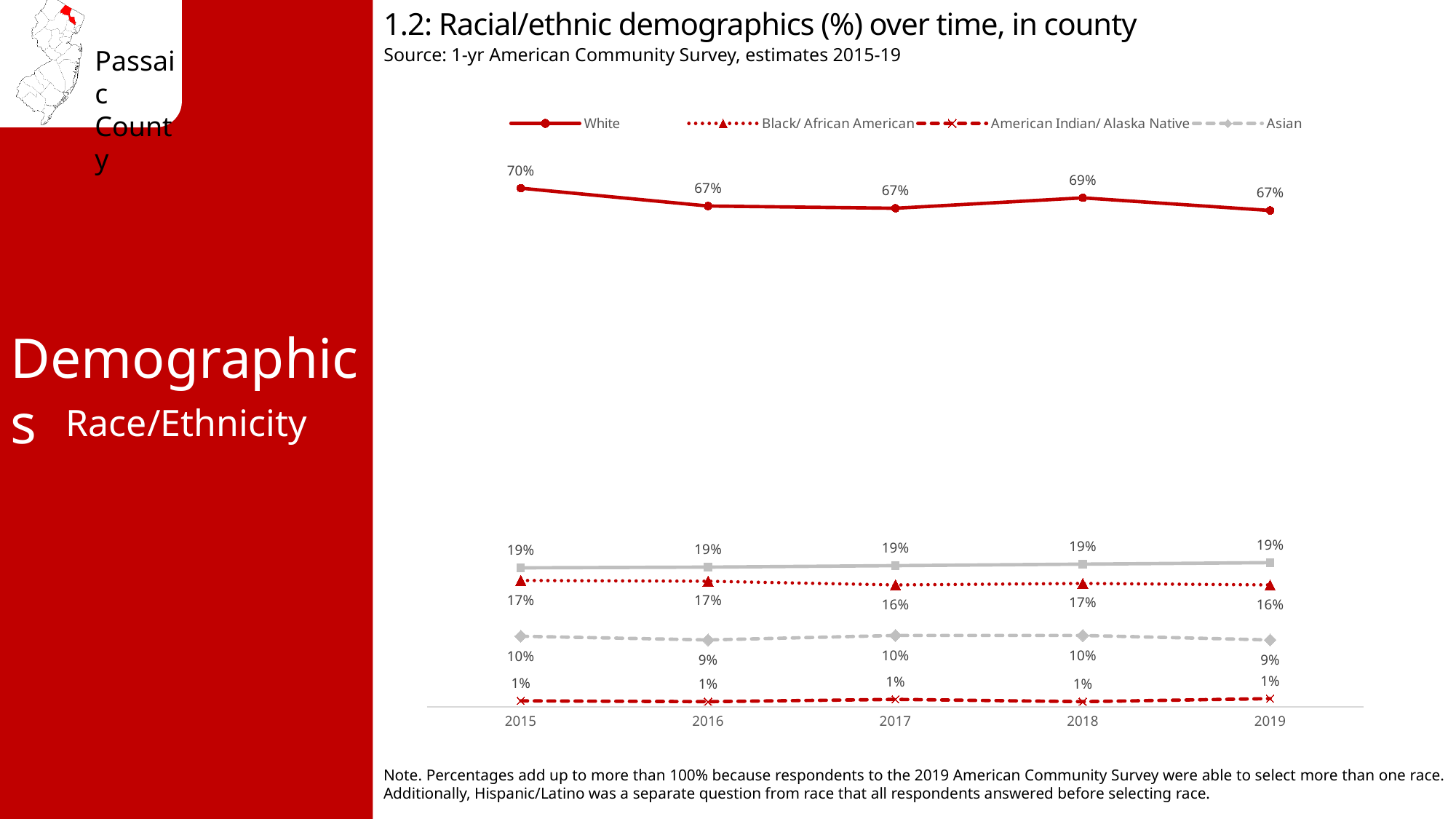
What is the difference between the White value in 2015 and in 2019? 3% How many years are shown on the x axis? 5 How many series does the legend list? 4 What is the value for White in 2018? 69% Which is larger in 2015, the Asian value or the Black/ African American value? Black/ African American In which year is the White series at its highest value? 2015 What kind of chart is shown on the slide? Line chart What is the value for White in 2015? 70% What is the value for Black/ African American in 2017? 16% What is the value for American Indian/ Alaska Native in 2019? 1% Does the White series rise or fall from 2015 to 2016? Fall What is the value for Asian in 2016? 9%